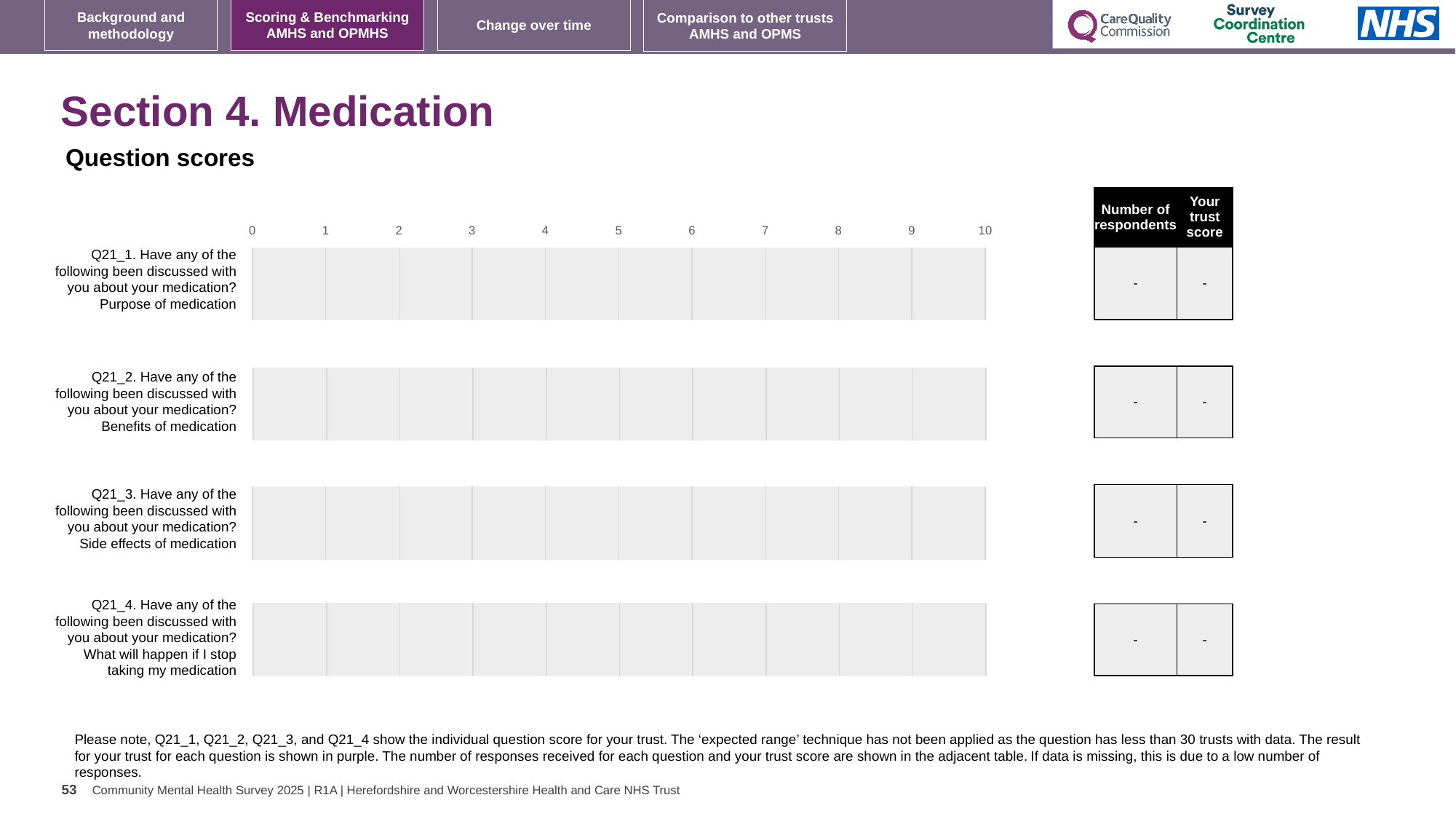
How many question rows (categories) are shown in the chart area on the slide? 4 What kind of chart is used for the question scores on the slide? bar chart What is the number of respondents shown in the table for Q21_1 (Purpose of medication)? - What is the heading above the charts on the slide? Question scores What is the trust score shown in the table for Q21_4 (What will happen if I stop taking my medication)? - What is the number of respondents shown in the table for Q21_2 (Benefits of medication)? - What is the maximum value shown on the chart's x axis? 10 What is the trust score shown in the table for Q21_3 (Side effects of medication)? -